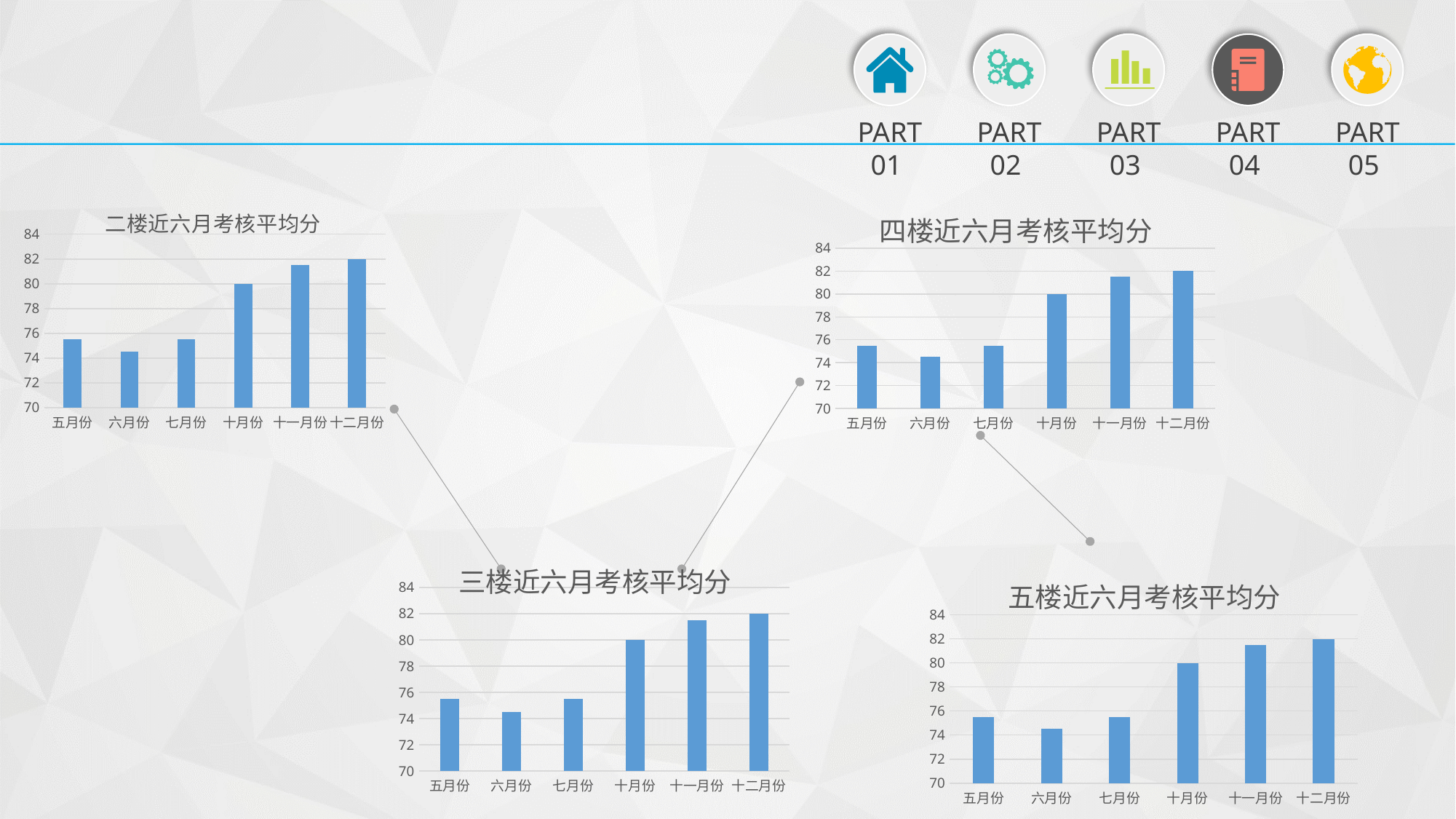
How many bar charts are on the slide? 4 In the '四楼近六月考核平均分' chart, what is the value for 十二月份? 82 In the '五楼近六月考核平均分' chart, is the value for 六月份 greater or less than 76? less In the '五楼近六月考核平均分' chart, do the values generally rise or fall from 七月份 to 十二月份? rise In the '二楼近六月考核平均分' chart, which is larger, the value for 十月份 or the value for 五月份? 十月份 What is the title of the chart in the bottom-right of the slide? 五楼近六月考核平均分 What kind of chart is the '二楼近六月考核平均分' chart? bar chart In the '三楼近六月考核平均分' chart, what is the difference between the values for 十二月份 and 十月份? 2 In the '二楼近六月考核平均分' chart, what is the value for 十月份? 80 In the '二楼近六月考核平均分' chart, how many months are shown on the x axis? 6 In the '四楼近六月考核平均分' chart, is the value for 十一月份 greater or less than 80? greater In the '三楼近六月考核平均分' chart, which month has the lowest value? 六月份